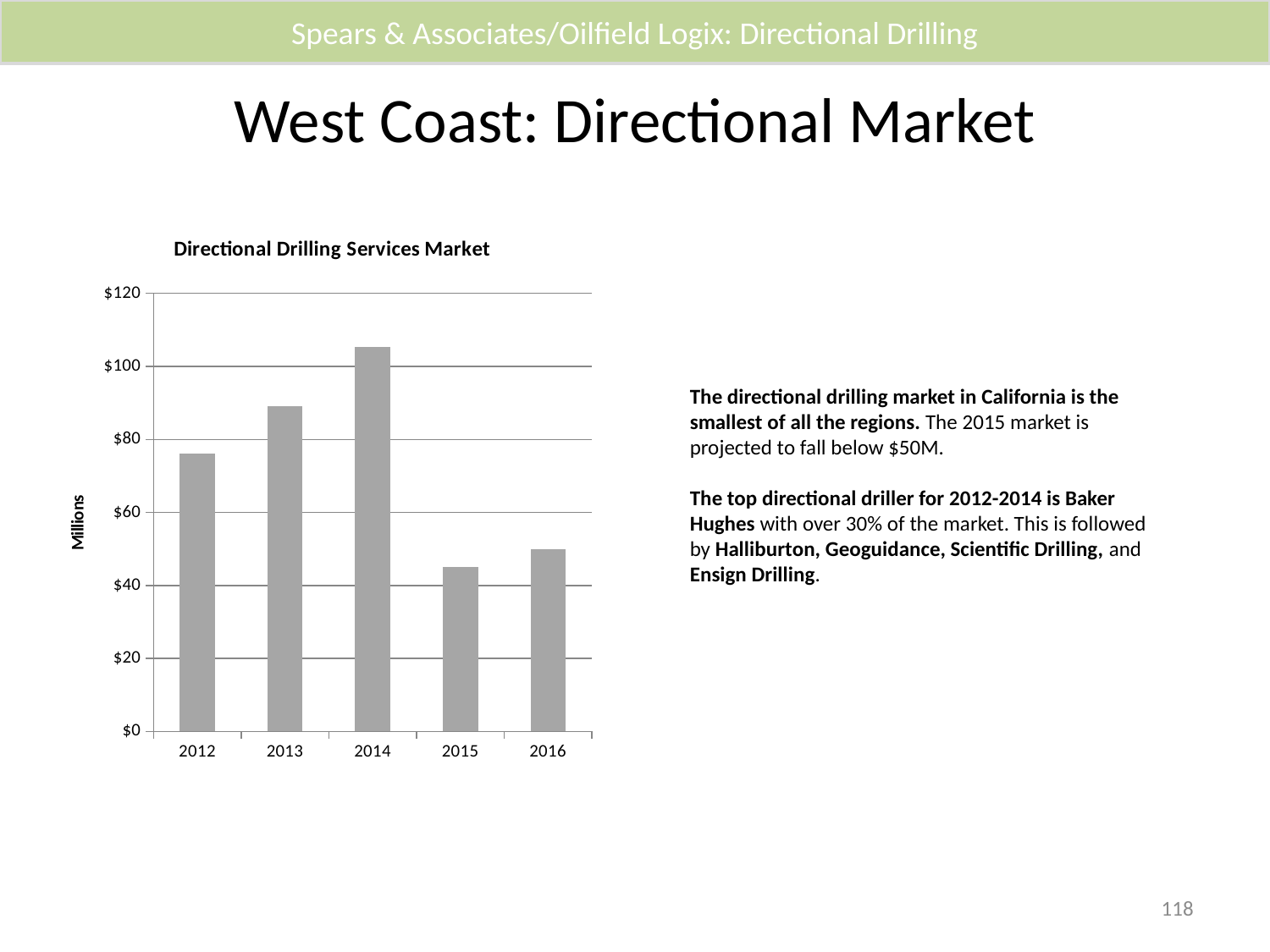
Which year has the lowest directional drilling services market value? 2015 How many years are plotted on the x axis of the chart? 5 Is the value for 2014 greater or less than $100? greater What is the title of the chart? Directional Drilling Services Market Is the value for 2015 greater or less than $60? less Which year has the highest directional drilling services market value? 2014 What kind of chart is shown on the slide? bar chart Is the value for 2012 greater or less than $60? greater Which year has the larger market value, 2012 or 2013? 2013 How do the values change from 2012 to 2014? they rise